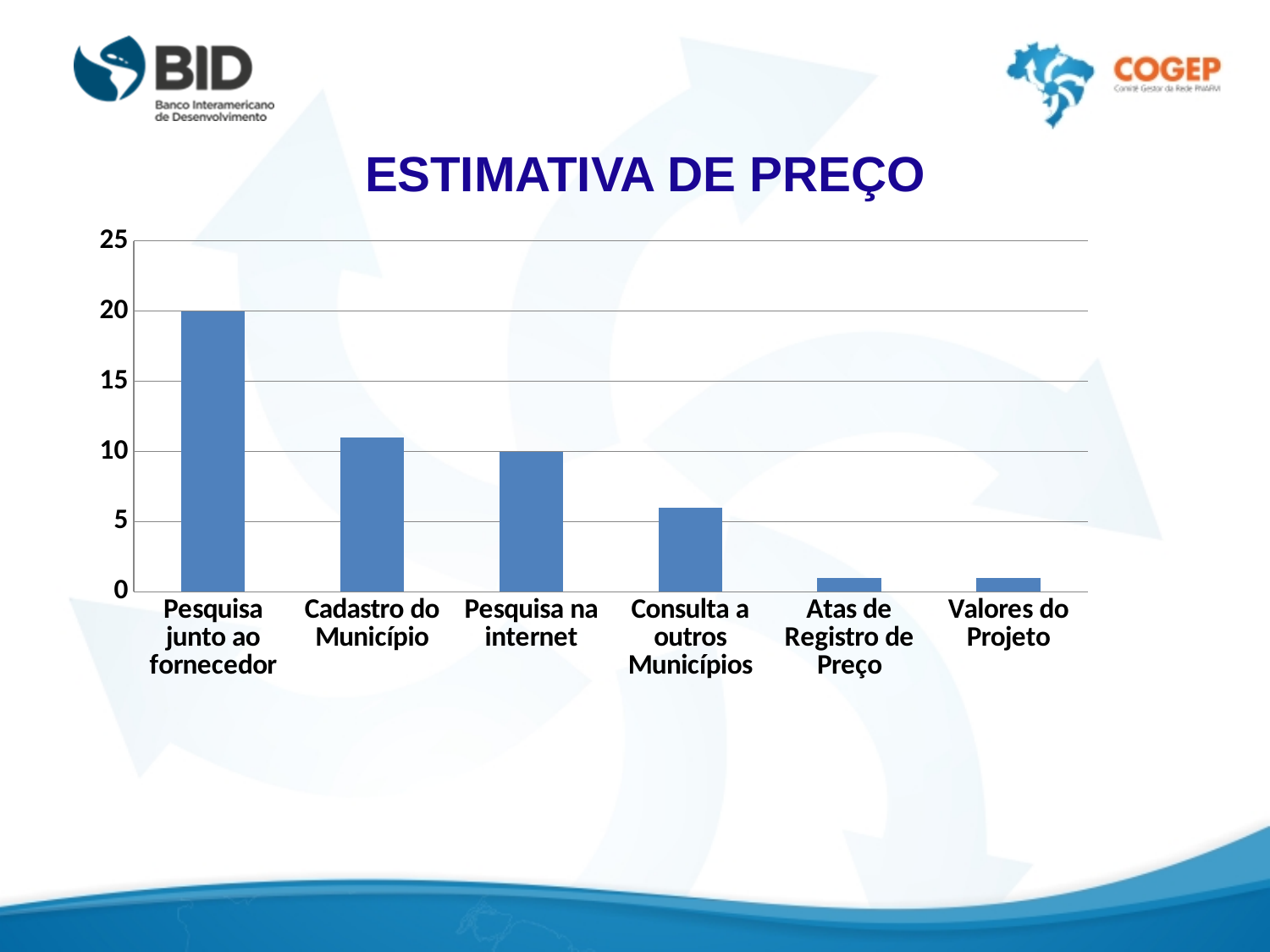
What is the value for Pesquisa na internet? 10 What is the value for Pesquisa junto ao fornecedor? 20 Which category has the highest value in the chart? Pesquisa junto ao fornecedor Is the value for Atas de Registro de Preço greater or less than 5? less Do the values rise or fall from left to right along the x axis? fall How many categories are shown on the x axis of the chart? 6 Is the value for Cadastro do Município greater or less than 10? greater What type of chart is shown on the slide? bar chart What is the title of the chart? ESTIMATIVA DE PREÇO Is the value for Consulta a outros Municípios greater or less than 5? greater Which is larger, the value for Cadastro do Município or the value for Consulta a outros Municípios? Cadastro do Município What is the difference between the values for Pesquisa junto ao fornecedor and Pesquisa na internet? 10